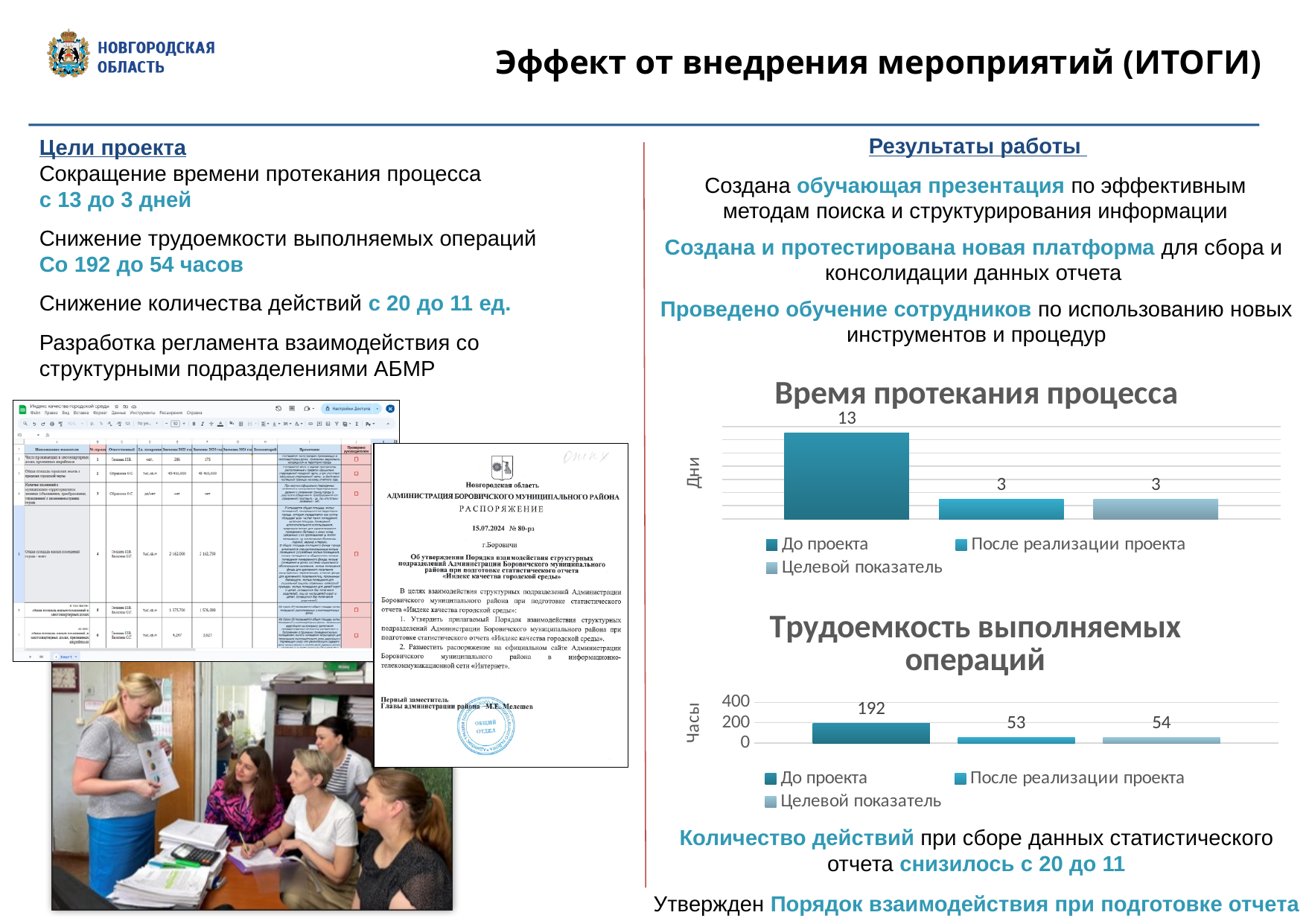
What kind of chart is the chart titled "Трудоемкость выполняемых операций"? Bar chart In the chart titled "Время протекания процесса", how many series does the legend list? 3 In the chart titled "Время протекания процесса", what is the difference between the "До проекта" value and the "Целевой показатель" value? 10 In the chart titled "Трудоемкость выполняемых операций", is the value for "До проекта" greater or less than 200? less In the chart titled "Трудоемкость выполняемых операций", what is the value for "Целевой показатель"? 54 In the chart titled "Трудоемкость выполняемых операций", which series has the lowest value? После реализации проекта In the chart titled "Время протекания процесса", what is the value for "После реализации проекта"? 3 In the chart titled "Трудоемкость выполняемых операций", what is the value for "До проекта"? 192 In the chart titled "Время протекания процесса", what is the value for "До проекта"? 13 In the chart titled "Время протекания процесса", which series has the highest value? До проекта In the chart titled "Время протекания процесса", what is the label on the vertical axis? Дни In the chart titled "Трудоемкость выполняемых операций", what is the difference between the "До проекта" value and the "После реализации проекта" value? 139